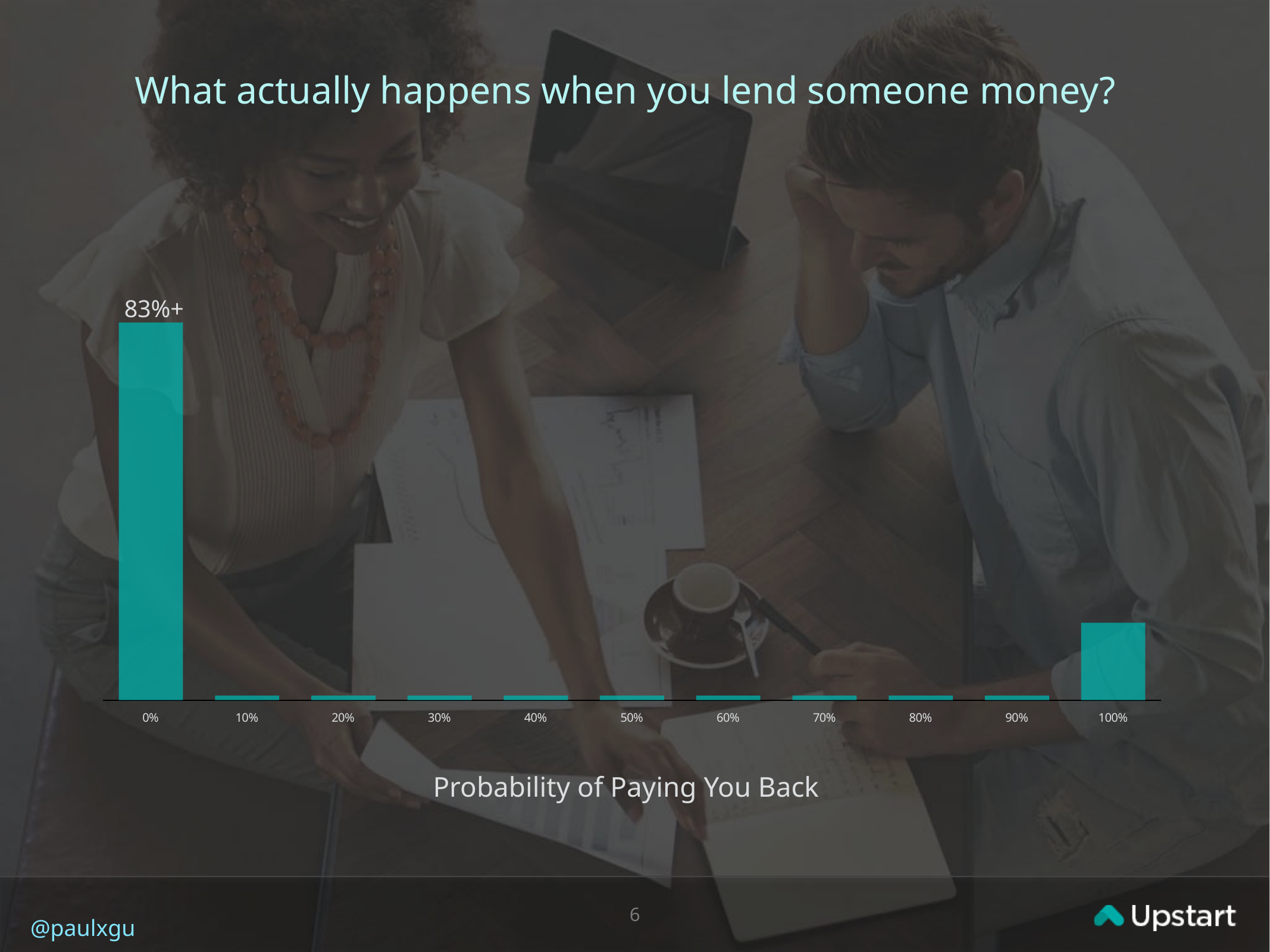
What kind of chart is shown on the slide? bar chart Which bar is taller, the one for 90% or the one for 100%? 100% Which bar is taller, the one for 0% or the one for 100%? 0% How many categories are shown along the x axis of the chart? 11 What is the title of the x axis of the chart? Probability of Paying You Back What value is labeled on the bar for the 0% category? 83%+ Which bar is taller, the one for 100% or the one for 50%? 100% What is the title of the slide containing the chart? What actually happens when you lend someone money? Which category has the tallest bar in the chart? 0%